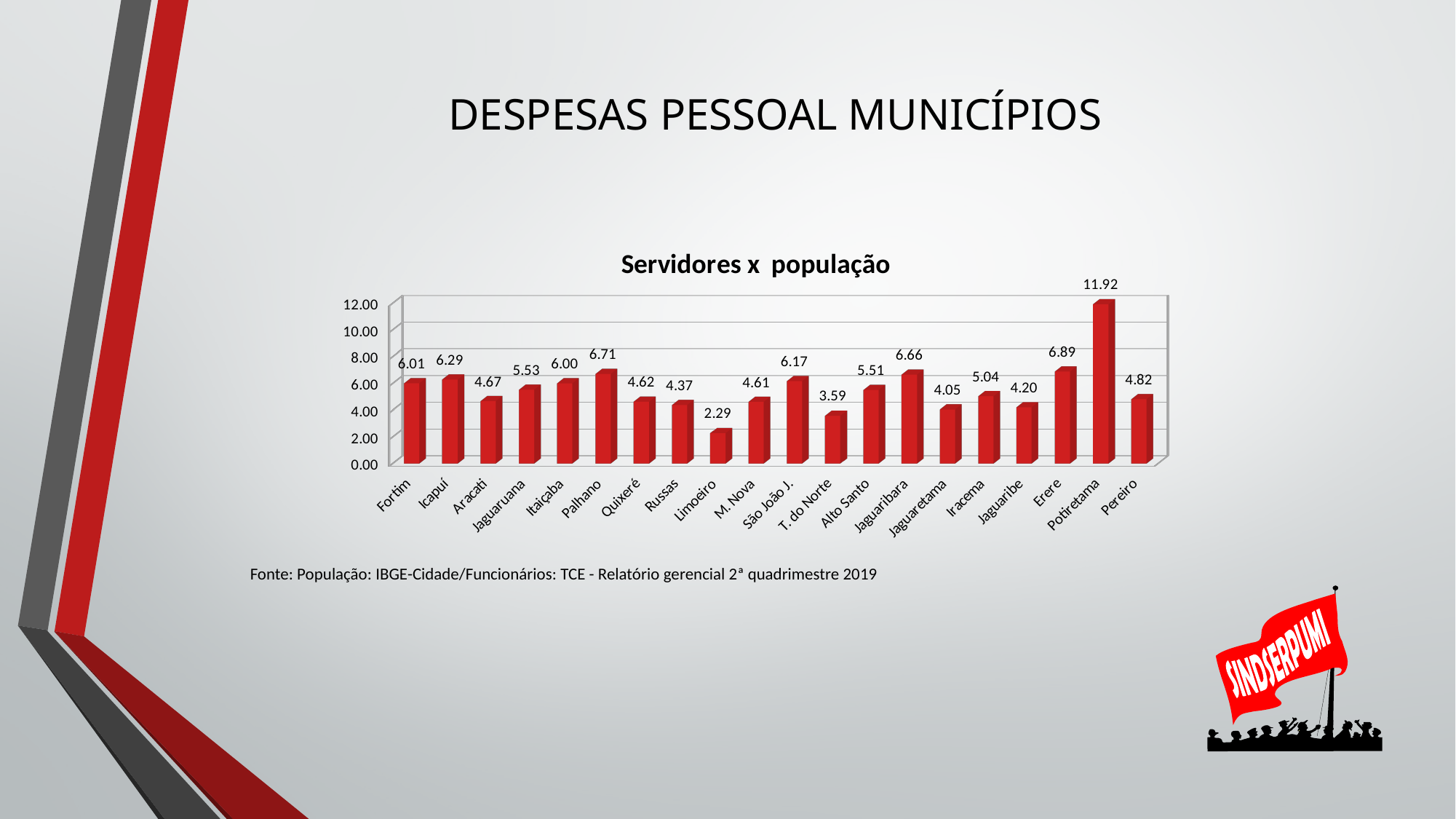
Which municipality has the highest value? Potiretama Which municipality has the lowest value? Limoeiro How many municipalities are shown on the chart? 20 Which is larger, the value for Jaguaribara or the value for Jaguaretama? Jaguaribara What kind of chart is shown on the slide? Bar chart What is the title of the chart? Servidores x população What is the difference between the values for Icapuí and Fortim? 0.28 What is the value for Palhano? 6.71 What is the value for T. do Norte? 3.59 What is the value for Limoeiro? 2.29 What is the difference between the values for Potiretama and Limoeiro? 9.63 What is the value for Potiretama? 11.92